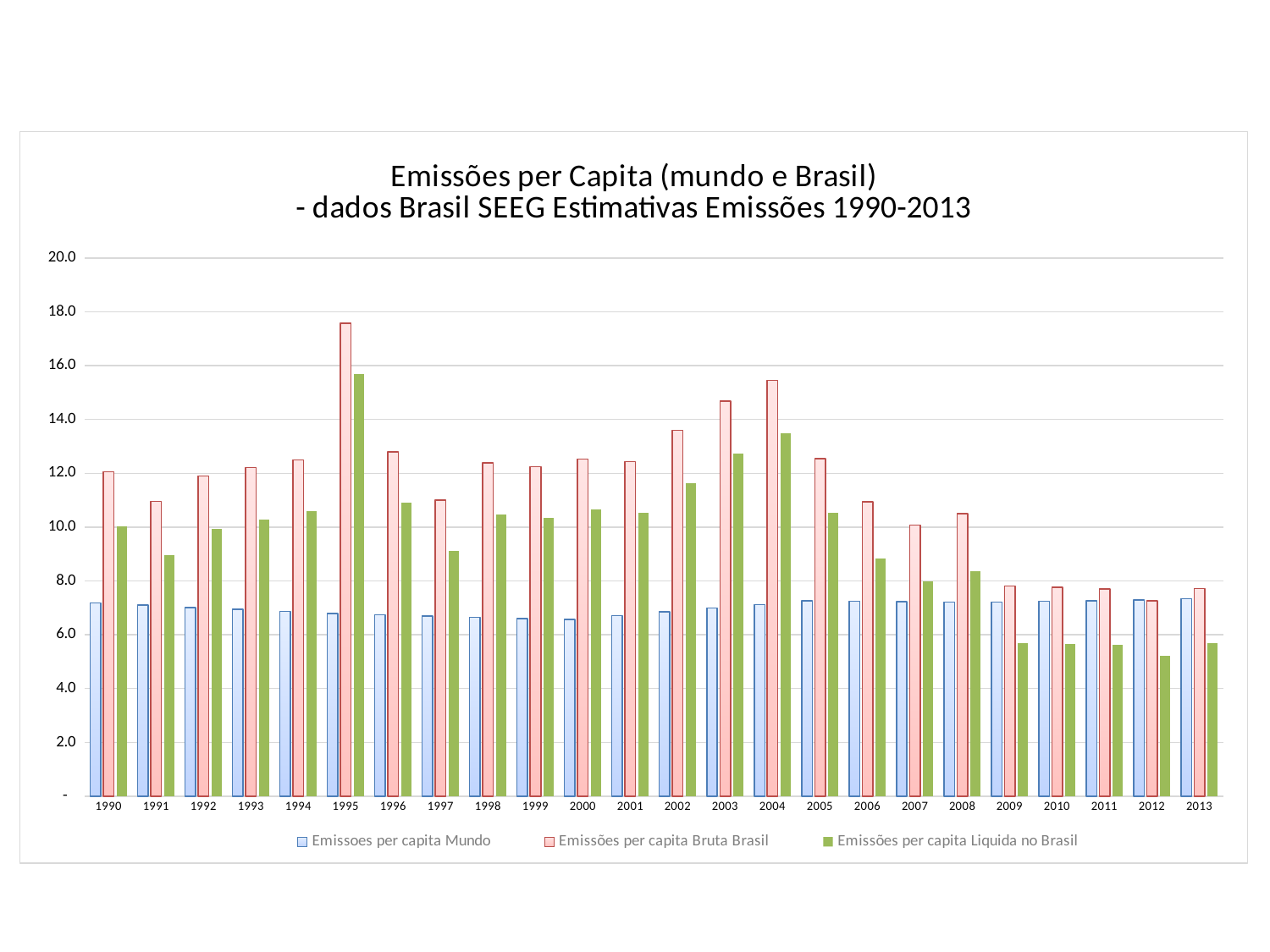
Which series is shown in green? Emissões per capita Liquida no Brasil In which year is the value for Emissões per capita Liquida no Brasil lowest? 2012 Is the value for Emissões per capita Bruta Brasil in 2004 greater or less than 14.0? greater In which year is the value for Emissões per capita Bruta Brasil highest? 1995 What kind of chart is shown on the slide? bar chart In which year is the value for Emissões per capita Liquida no Brasil highest? 1995 Do the values for Emissões per capita Bruta Brasil rise or fall from 2004 to 2013? fall How many series does the legend list? 3 Which is larger in 2010: Emissoes per capita Mundo or Emissões per capita Liquida no Brasil? Emissoes per capita Mundo Is the value for Emissões per capita Bruta Brasil in 1995 greater or less than 16.0? greater How many years are shown along the x axis? 24 Is the value for Emissões per capita Liquida no Brasil in 2012 greater or less than 6.0? less